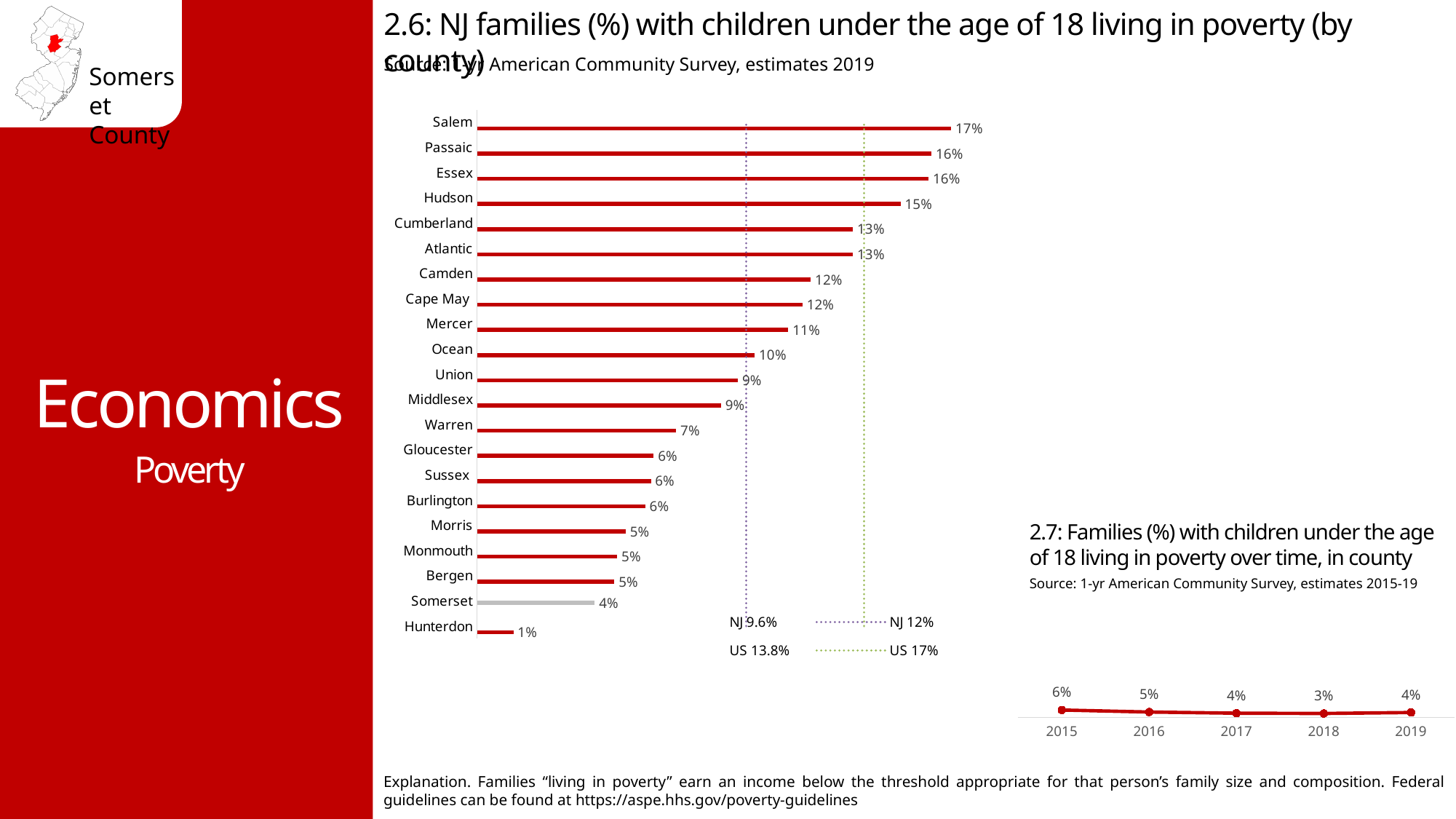
In chart 2.6, which county has the highest percentage of families with children living in poverty? Salem In chart 2.6, which county has a larger value, Hudson or Mercer? Hudson In chart 2.7, how many years are plotted? 5 In chart 2.7 (families with children under 18 living in poverty over time), what is the value for 2018? 3% In chart 2.6, what NJ reference value is shown by the purple dotted line? NJ 9.6% In chart 2.6, how many counties are shown? 21 In chart 2.6, what is the value for Warren? 7% In chart 2.6, what is the difference between the values for Salem and Somerset? 13 percentage points In chart 2.6 (NJ families with children under 18 living in poverty by county), what is the value for Somerset? 4% In chart 2.7, do the values generally rise or fall from 2015 to 2018? Fall In chart 2.6, which county has the lowest percentage of families with children living in poverty? Hunterdon What kind of chart is chart 2.6? Bar chart